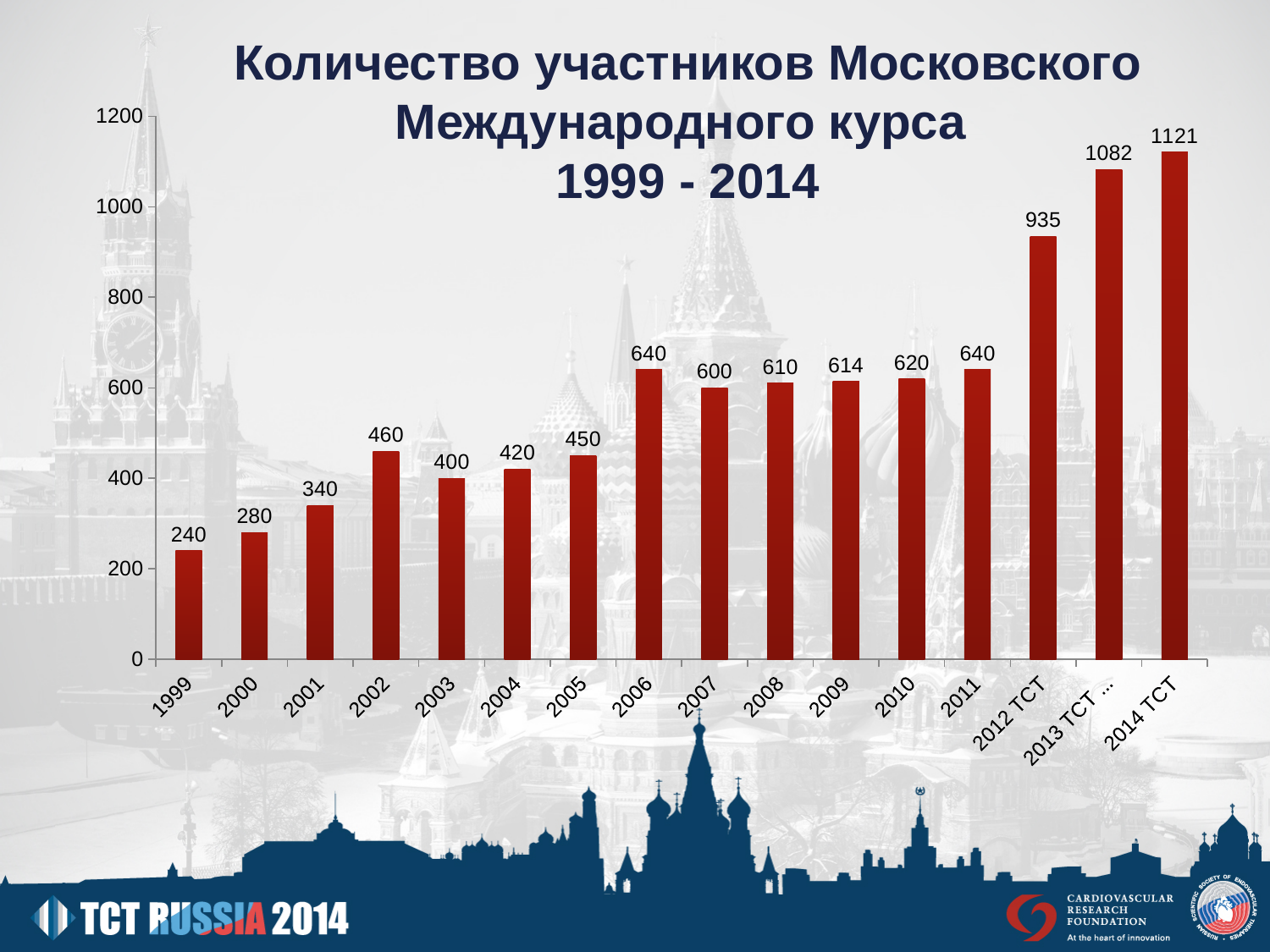
What years does the chart title say the data covers? 1999 - 2014 Which is larger, the value for 2002 or the value for 2003? 2002 How many participants were there in 1999? 240 What is the value shown for 2013 TCT? 1082 Do the values generally rise or fall from 1999 to 2014 TCT? Rise What type of chart is shown on the slide? Bar chart Which category has the lowest value? 1999 What is the difference between the values for 2014 TCT and 2012 TCT? 186 What is the value shown for 2009? 614 What is the value shown for 2003? 400 How many bars are plotted in the chart? 16 Which category has the highest value? 2014 TCT